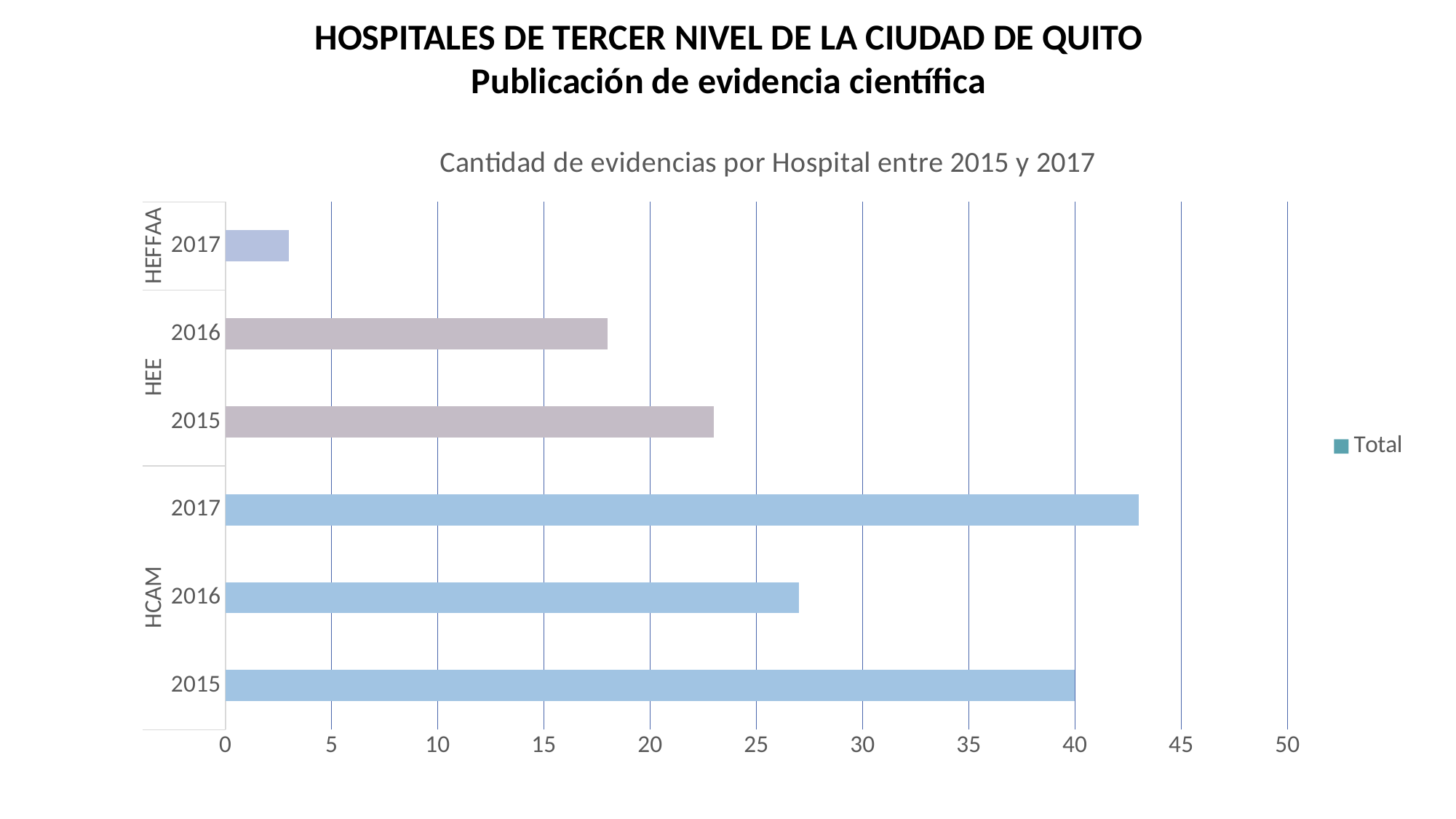
Is the value for HCAM in 2017 greater or less than 40? greater What is the name of the series shown in the legend? Total How many bars are plotted in the chart? 6 How many series does the legend list? 1 What is the value for HCAM in 2015? 40 Which hospital and year has the lowest number of evidences? HEFFAA 2017 Is the value for HEFFAA in 2017 greater or less than 5? less What kind of chart is shown on the slide? bar chart What is the chart's subtitle above the plot area? Cantidad de evidencias por Hospital entre 2015 y 2017 Which is larger, the value for HEE in 2015 or HEE in 2016? HEE 2015 Which hospital and year has the highest number of evidences? HCAM 2017 Is the value for HEE in 2016 greater or less than 20? less